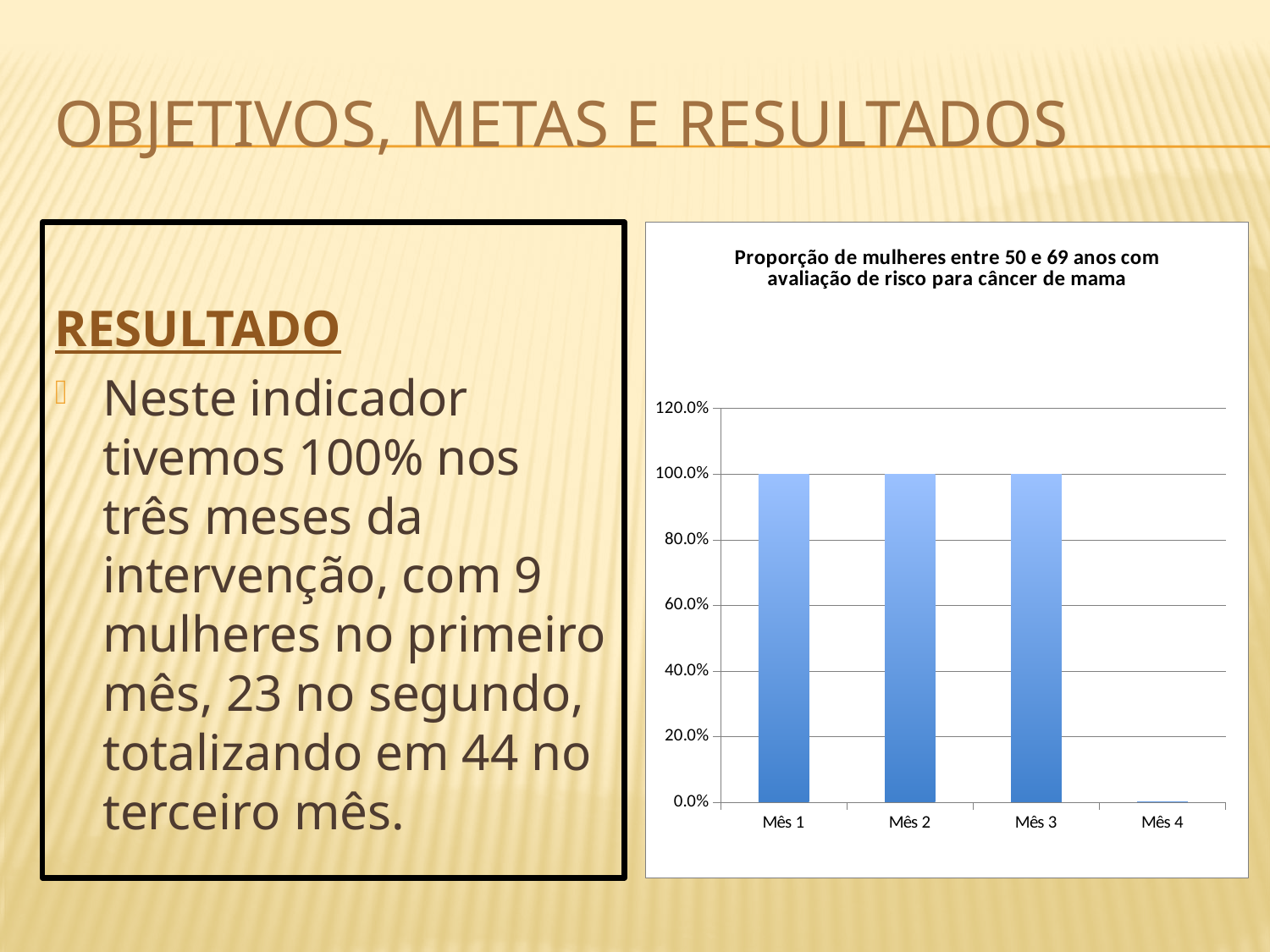
What kind of chart is shown on the slide? bar chart What is the value for Mês 1 in the chart? 100.0% Is the value for Mês 2 greater or less than 80.0%? greater What is the difference between the values for Mês 1 and Mês 3? 0.0% Do the values rise, fall or stay the same from Mês 1 to Mês 3? stay the same What is the value for Mês 2 in the chart? 100.0% Which month has the lowest value in the chart? Mês 4 How many categories (months) are shown on the x axis of the chart? 4 Which is larger, the value for Mês 1 or the value for Mês 4? Mês 1 Is the value for Mês 4 greater or less than 20.0%? less What is the title of the chart? Proporção de mulheres entre 50 e 69 anos com avaliação de risco para câncer de mama What is the value for Mês 3 in the chart? 100.0%